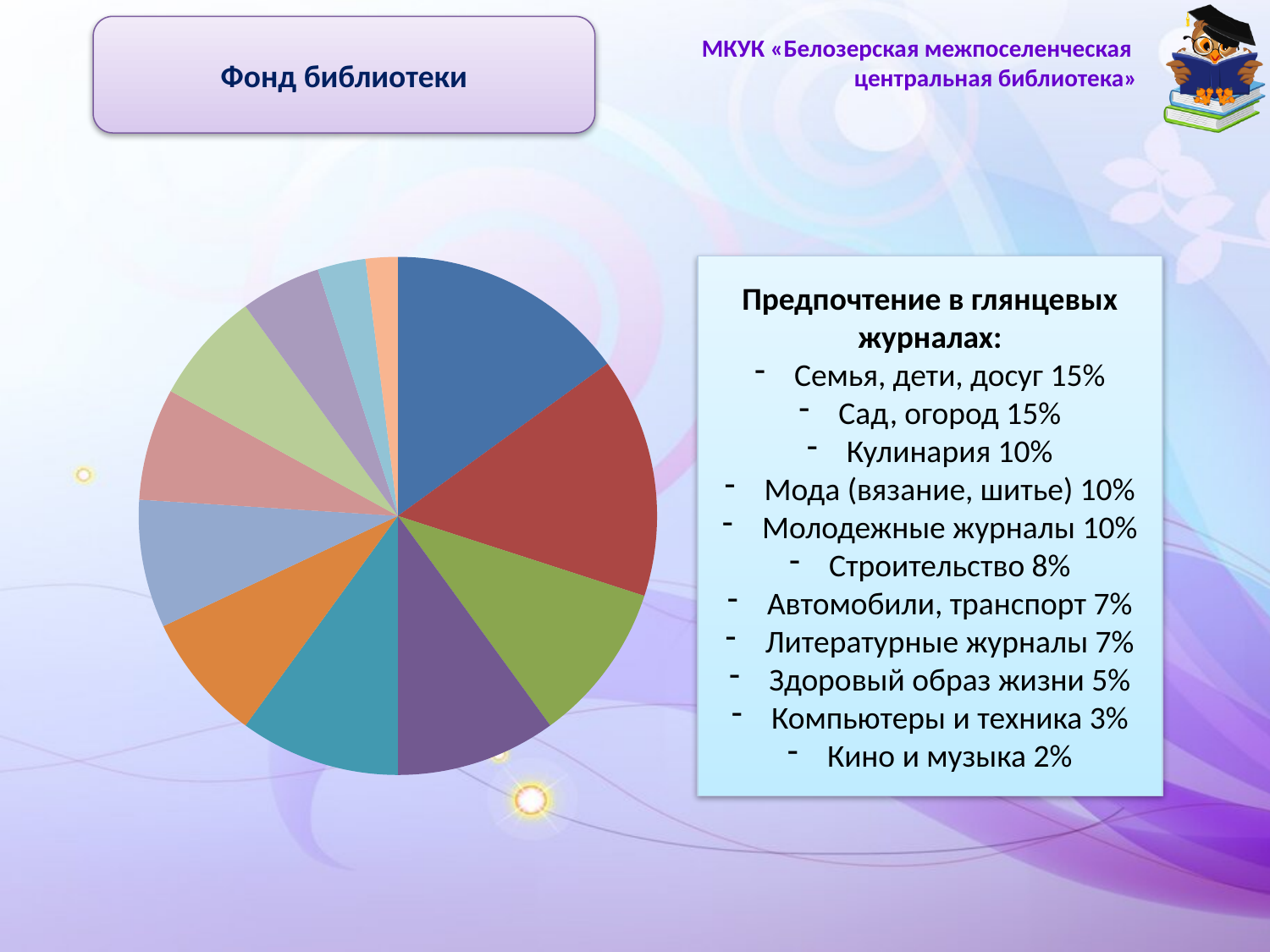
What is the heading of the text box that lists the chart's categories? Предпочтение в глянцевых журналах What is the title shown in the box at the top left of the slide? Фонд библиотеки What is the share of Кино и музыка? 2% What percentage is given for Компьютеры и техника? 3% What is the difference between the percentages for Кулинария and Строительство? 2% What percentage is given for Здоровый образ жизни? 5% Which is larger, the share for Автомобили, транспорт or for Здоровый образ жизни? Автомобили, транспорт How many categories are listed in the text box next to the pie chart? 11 What percentage is given for Кулинария? 10% What percentage is given for Строительство? 8% What kind of chart is shown on the slide? pie chart Which category has the smallest share? Кино и музыка